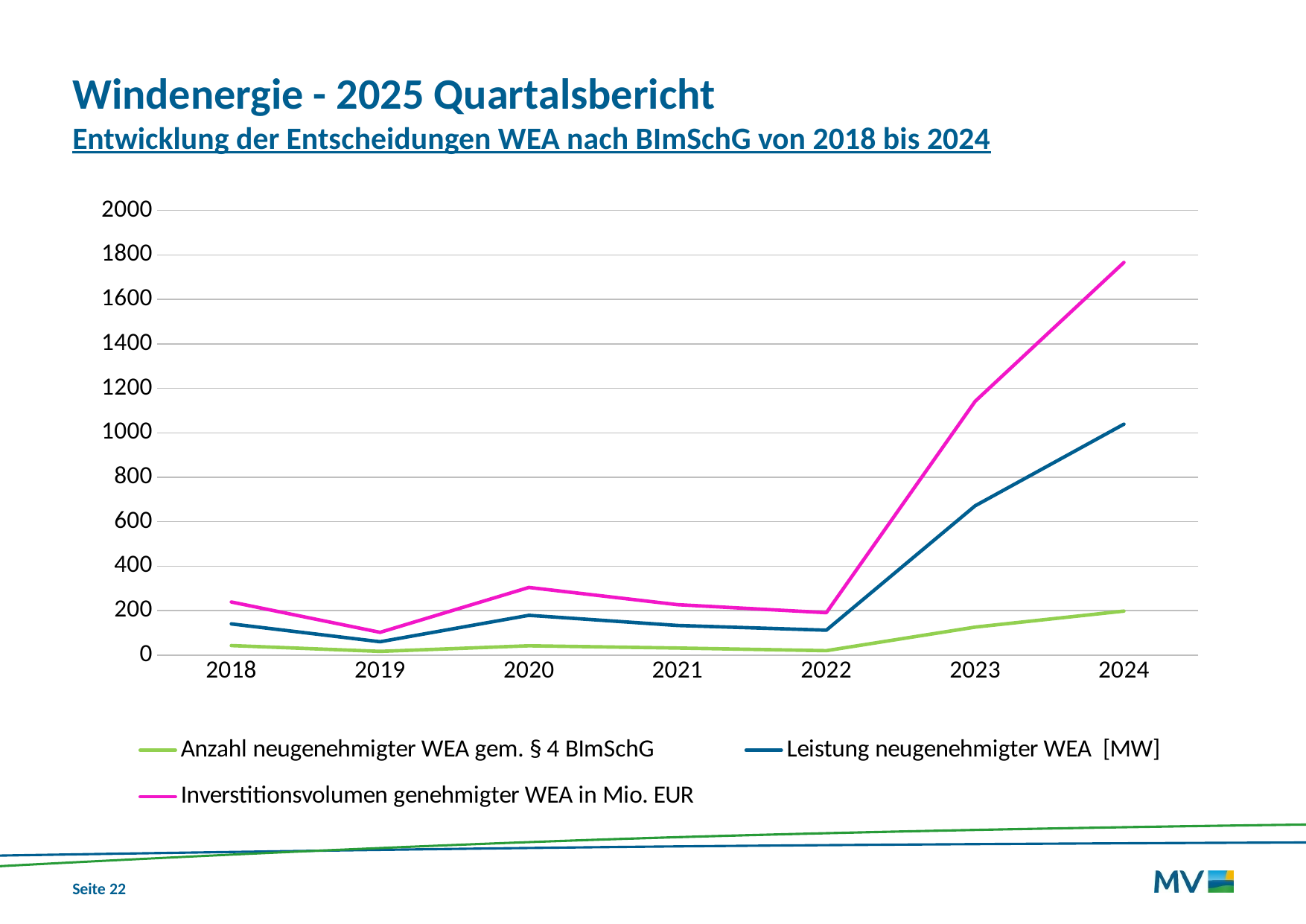
In which year is the value for 'Leistung neugenehmigter WEA [MW]' highest? 2024 What kind of chart is shown on the slide? line chart In which year is the value for 'Inverstitionsvolumen genehmigter WEA in Mio. EUR' highest? 2024 In 2024, which is larger: 'Inverstitionsvolumen genehmigter WEA in Mio. EUR' or 'Leistung neugenehmigter WEA [MW]'? Inverstitionsvolumen genehmigter WEA in Mio. EUR Is the value for 'Leistung neugenehmigter WEA [MW]' in 2023 greater or less than 800? less Is the value for 'Inverstitionsvolumen genehmigter WEA in Mio. EUR' in 2024 greater or less than 1600? greater In which year is the value for 'Inverstitionsvolumen genehmigter WEA in Mio. EUR' lowest? 2019 Does the value for 'Inverstitionsvolumen genehmigter WEA in Mio. EUR' rise or fall from 2022 to 2024? rise Which colour is used for the 'Leistung neugenehmigter WEA [MW]' line? dark blue Is the value for 'Anzahl neugenehmigter WEA gem. § 4 BImSchG' in 2024 greater or less than 400? less How many years are plotted along the x axis? 7 How many series does the legend list? 3